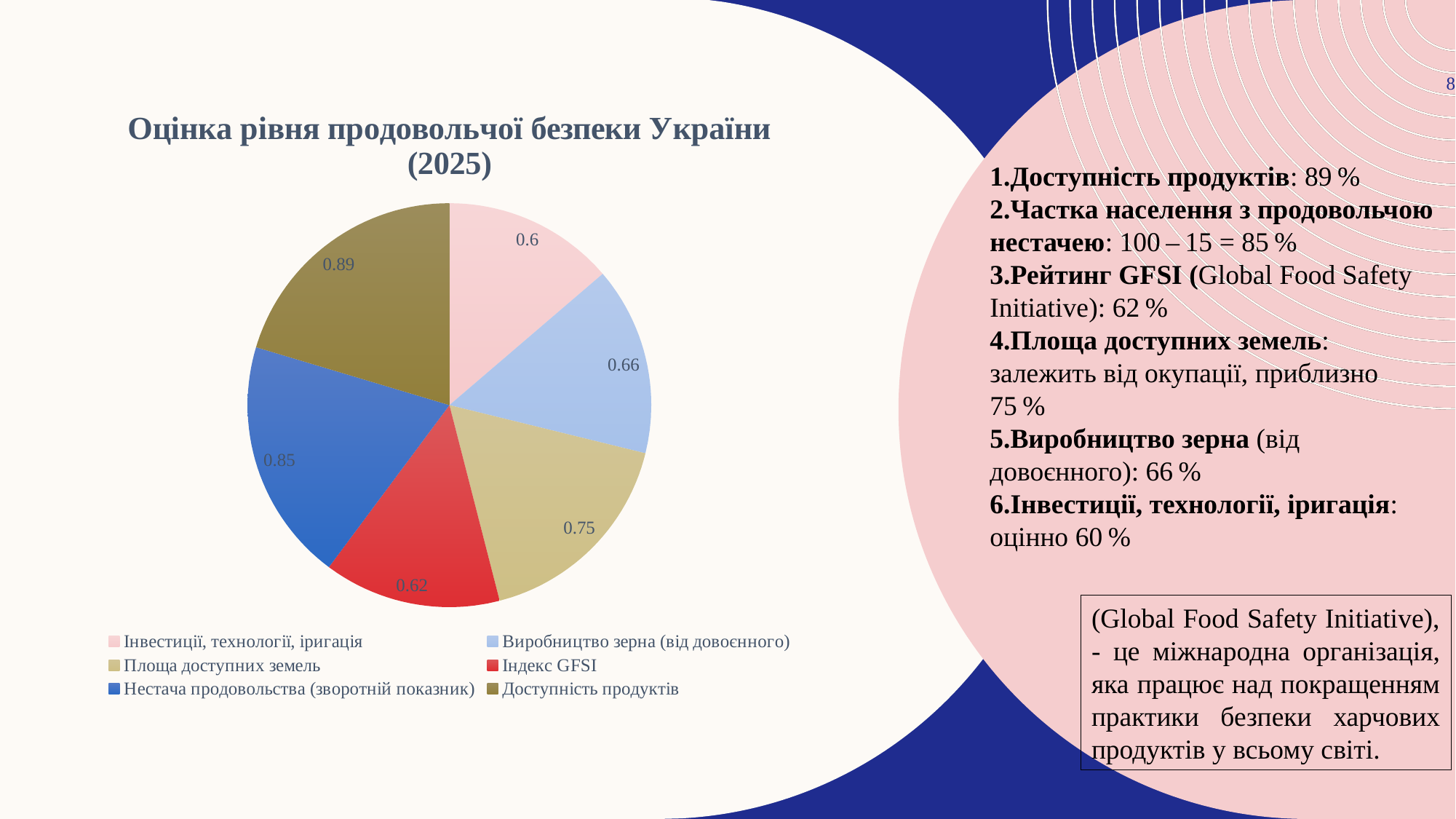
What is the difference between the values for Доступність продуктів and Площа доступних земель? 0.14 What is the value for Доступність продуктів? 0.89 What is the value for Індекс GFSI? 0.62 Which category has the lowest value? Інвестиції, технології, іригація Which category has the highest value? Доступність продуктів What is the title of the chart? Оцінка рівня продовольчої безпеки України (2025) How many slices does the pie chart have? 6 What is the value for Виробництво зерна (від довоєнного)? 0.66 Which is larger: the value for Площа доступних земель or the value for Індекс GFSI? Площа доступних земель What is the value for Нестача продовольства (зворотній показник)? 0.85 Which colour represents Індекс GFSI in the legend? Red What type of chart is shown on the slide? Pie chart